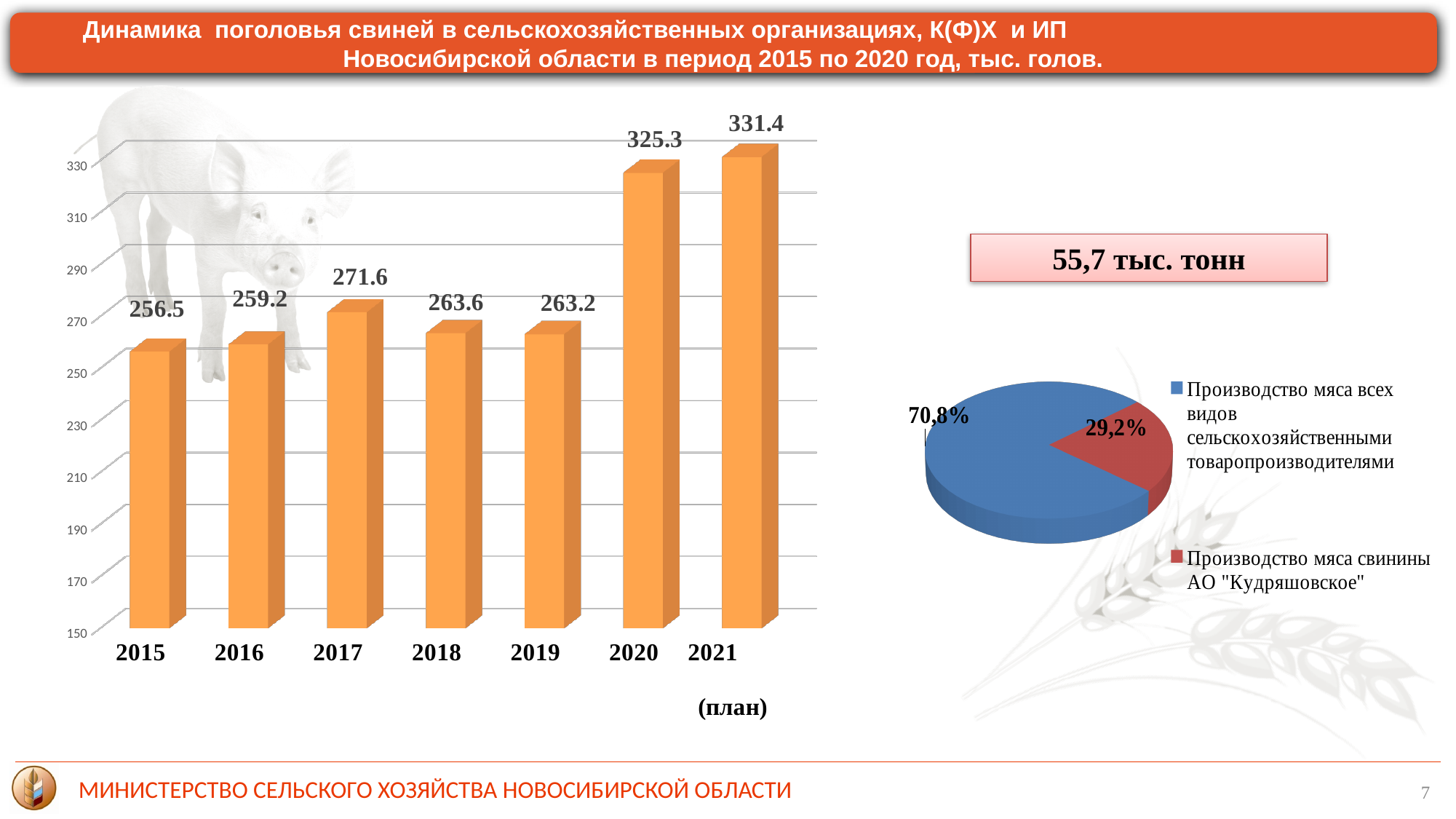
How many entries does the legend of the pie chart list? 2 On the pie chart, what share is shown for Производство мяса свинины АО "Кудряшовское"? 29,2% On the bar chart, what is the value for 2017? 271.6 On the bar chart, which is larger, the value for 2018 or the value for 2019? 2018 On the bar chart, which year has the highest value? 2021 (план) On the bar chart, do the values rise or fall from 2019 to 2021 (план)? rise On the bar chart, which year has the lowest value? 2015 On the bar chart, is the value for 2016 greater or less than 270? less On the bar chart, what is the value for 2020? 325.3 On the bar chart, what is the difference between the values for 2017 and 2015? 15.1 How many years are shown on the bar chart? 7 On the bar chart, what is the difference between the values for 2021 (план) and 2020? 6.1